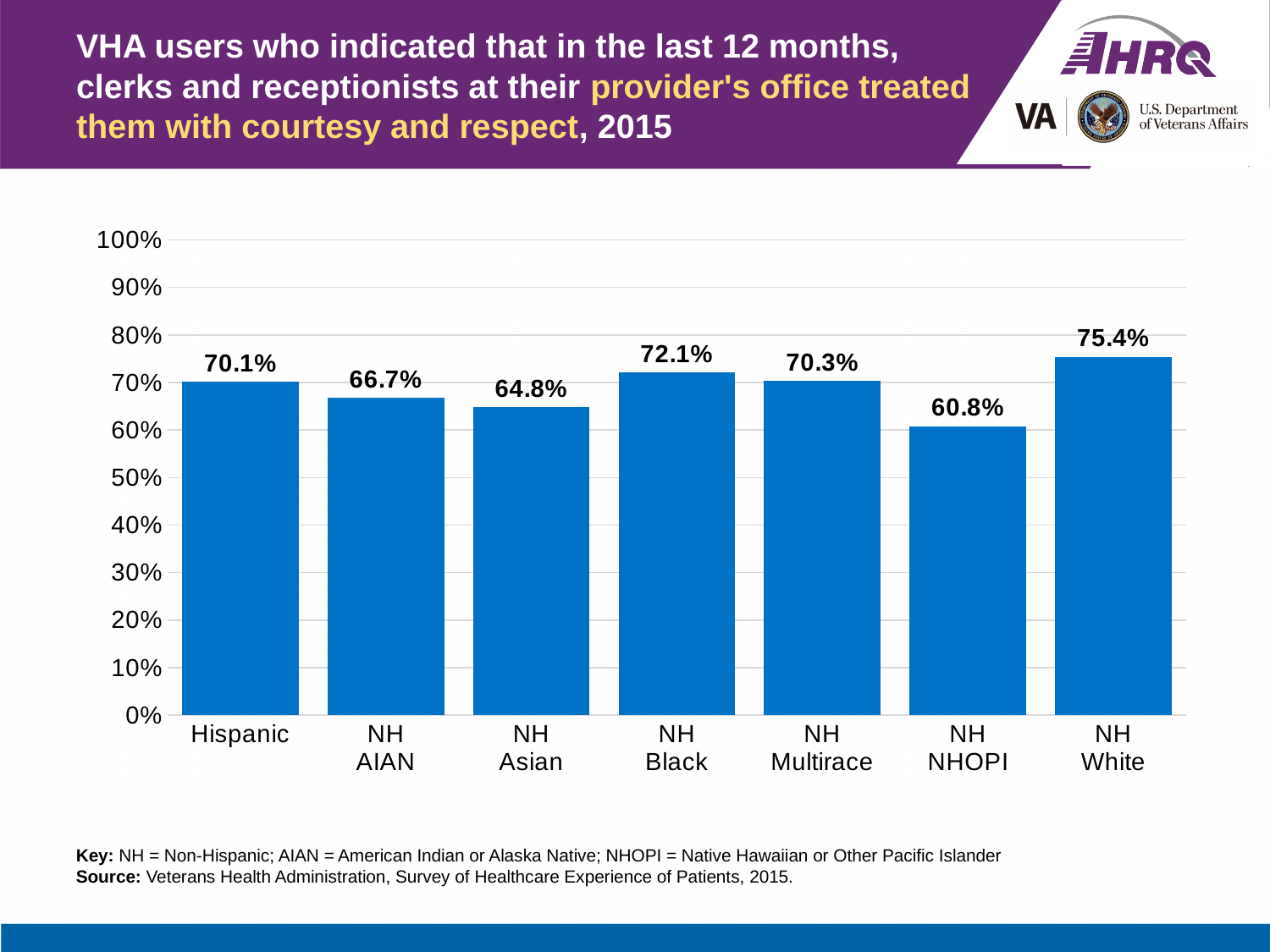
Which category has the highest value? NH White According to the key, what does NHOPI stand for? Native Hawaiian or Other Pacific Islander Is the value for NH Multirace greater or less than 60%? greater What kind of chart is shown on the slide? bar chart What is the value for NH NHOPI? 60.8% What is the value for Hispanic? 70.1% How many categories are shown on the x axis? 7 Which is larger, the value for NH AIAN or the value for NH Asian? NH AIAN What is the difference between the values for NH White and NH NHOPI? 14.6% Which category has the lowest value? NH NHOPI What is the value for NH Black? 72.1% What is the difference between the values for NH Black and NH Asian? 7.3%